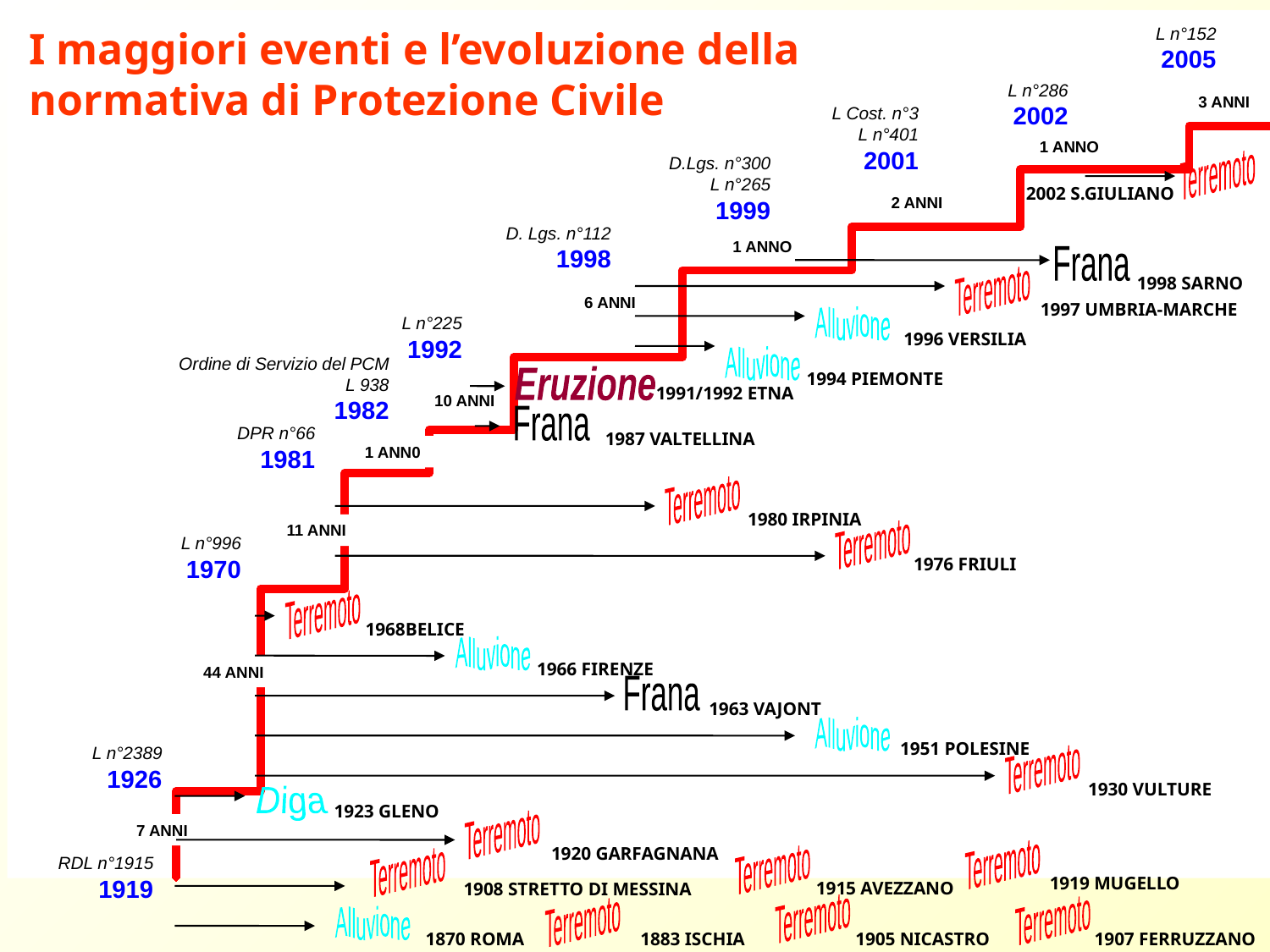
What type of event is labelled for 1963 VAJONT? Frana What type of event is labelled for 1923 GLENO? Diga What interval label is shown between the 1926 and 1970 steps of the timeline? 44 ANNI What type of event is labelled for 1966 FIRENZE? Alluvione Which law is shown for the year 1992? L n°225 Which law is shown for the year 2005? L n°152 What year is shown for the law "L n°2389"? 1926 What interval label is shown between the 1919 and 1926 steps? 7 ANNI What interval label is shown between the 1970 and 1981 steps? 11 ANNI Which years are given for the ETNA eruption? 1991/1992 What interval label is shown after the 2002 step, at the top right of the timeline? 3 ANNI What type of event is labelled for 1980 IRPINIA? Terremoto